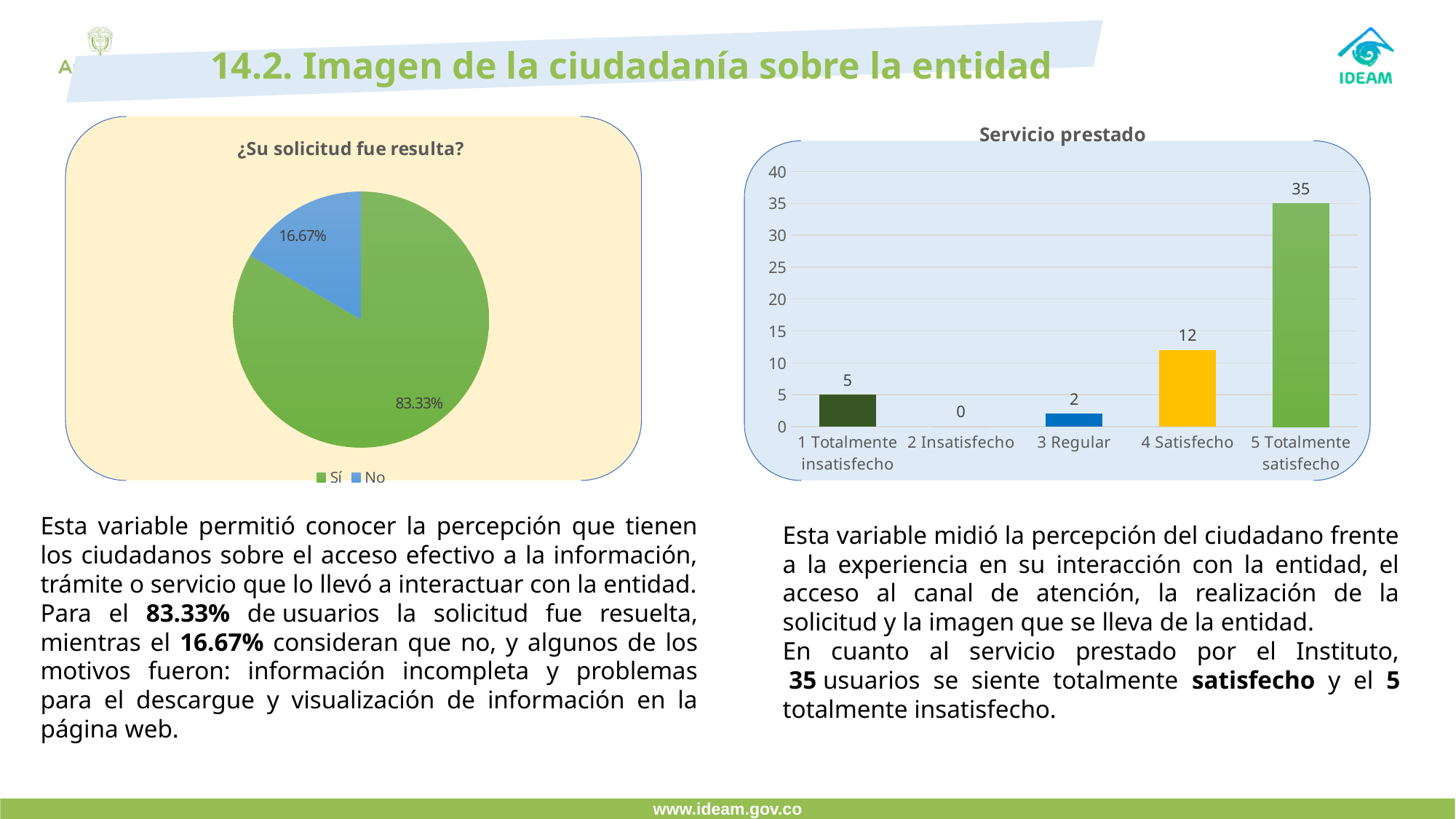
In the 'Servicio prestado' chart, what is the difference between 5 Totalmente satisfecho and 4 Satisfecho? 23 In the 'Servicio prestado' chart, which category has the highest value? 5 Totalmente satisfecho What kind of chart is '¿Su solicitud fue resulta?'? pie chart In the '¿Su solicitud fue resulta?' pie chart, what share is labelled for No? 16.67% What kind of chart is 'Servicio prestado'? bar chart How many entries does the legend of the '¿Su solicitud fue resulta?' chart list? 2 In the 'Servicio prestado' chart, what is the value for 2 Insatisfecho? 0 In the 'Servicio prestado' chart, what is the value for 5 Totalmente satisfecho? 35 How many categories are shown in the 'Servicio prestado' chart? 5 In the '¿Su solicitud fue resulta?' pie chart, which slice is larger, Sí or No? Sí In the '¿Su solicitud fue resulta?' pie chart, what share is labelled for Sí? 83.33% In the 'Servicio prestado' chart, what is the value for 4 Satisfecho? 12